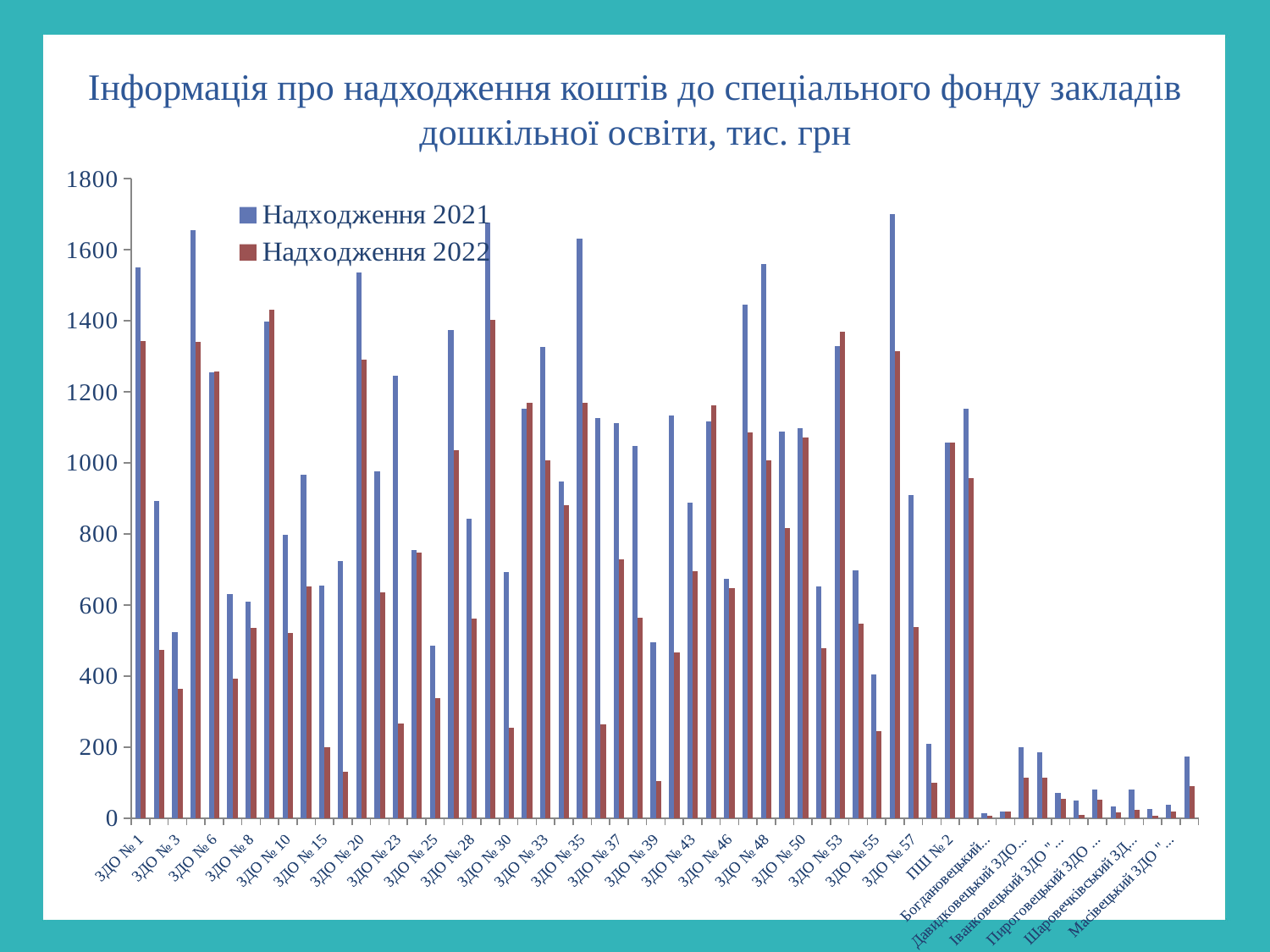
Is the Надходження 2021 value for ЗДО № 35 greater or less than 1400? greater Is the Надходження 2021 value for ЗДО № 1 greater or less than 1400? greater What unit is stated in the chart title? тис. грн Is the Надходження 2022 value for ЗДО № 15 greater or less than 400? less What kind of chart is shown on the slide? bar chart Which is larger: the Надходження 2021 value for ЗДО № 35 or the Надходження 2021 value for ЗДО № 55? ЗДО № 35 How many series does the legend list? 2 What are the two series named in the legend? Надходження 2021 and Надходження 2022 For ЗДО № 15, which series has the larger value, Надходження 2021 or Надходження 2022? Надходження 2021 For ЗДО № 23, which series has the larger value, Надходження 2021 or Надходження 2022? Надходження 2021